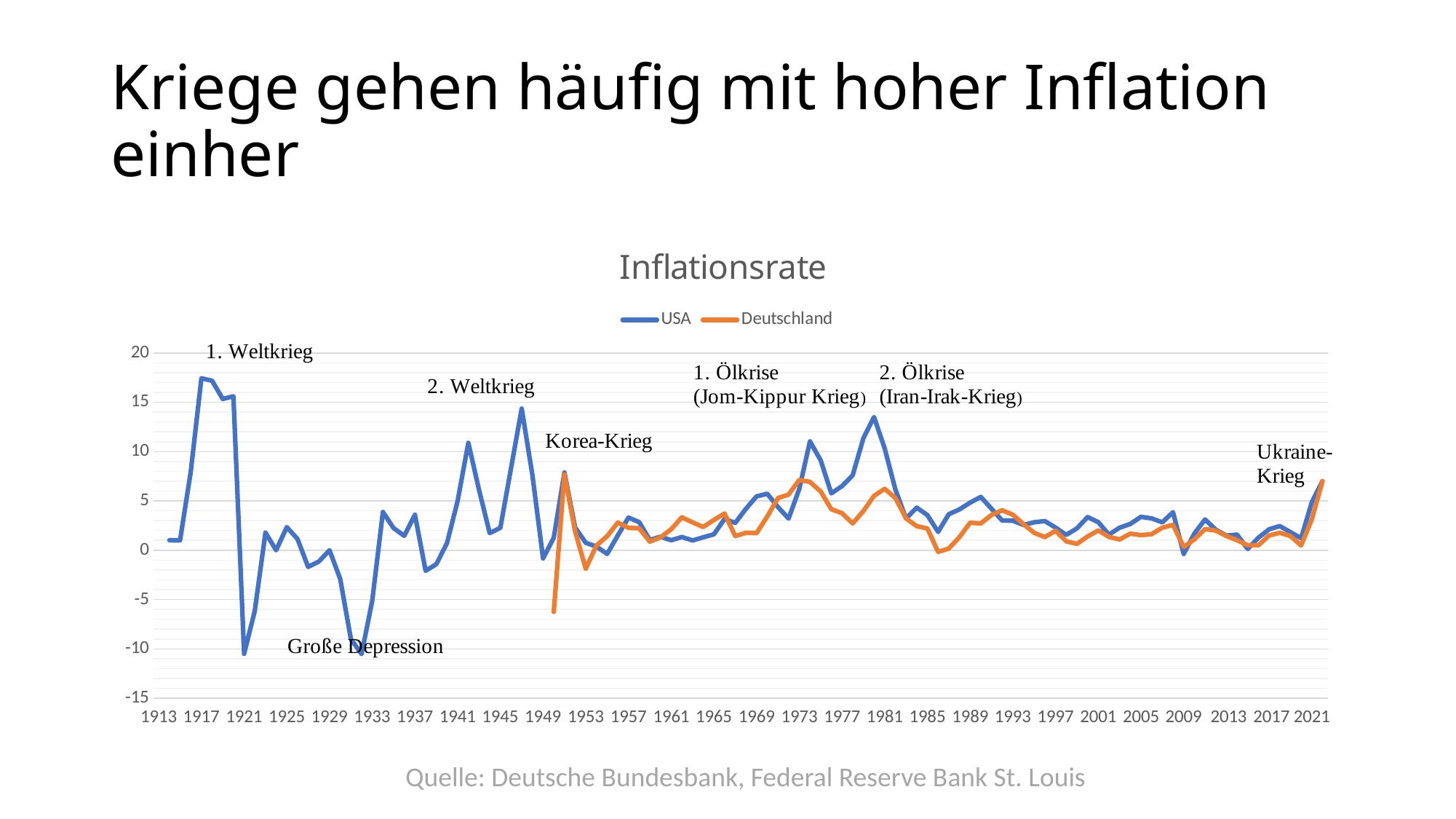
How many series does the legend of the chart list? 2 Is the USA inflation rate in 1980 greater or less than 10? greater Is the USA inflation rate in 1947 greater or less than 10? greater In 1980, which series has the higher inflation rate, USA or Deutschland? USA What kind of chart is shown on the slide? line chart Is the Deutschland inflation rate in 1973 greater or less than 5? greater Which series is drawn in orange in the chart? Deutschland Which series reaches the highest value anywhere on the chart? USA Does the USA inflation rate rise or fall between 1980 and 1985? fall What is the title of the chart? Inflationsrate